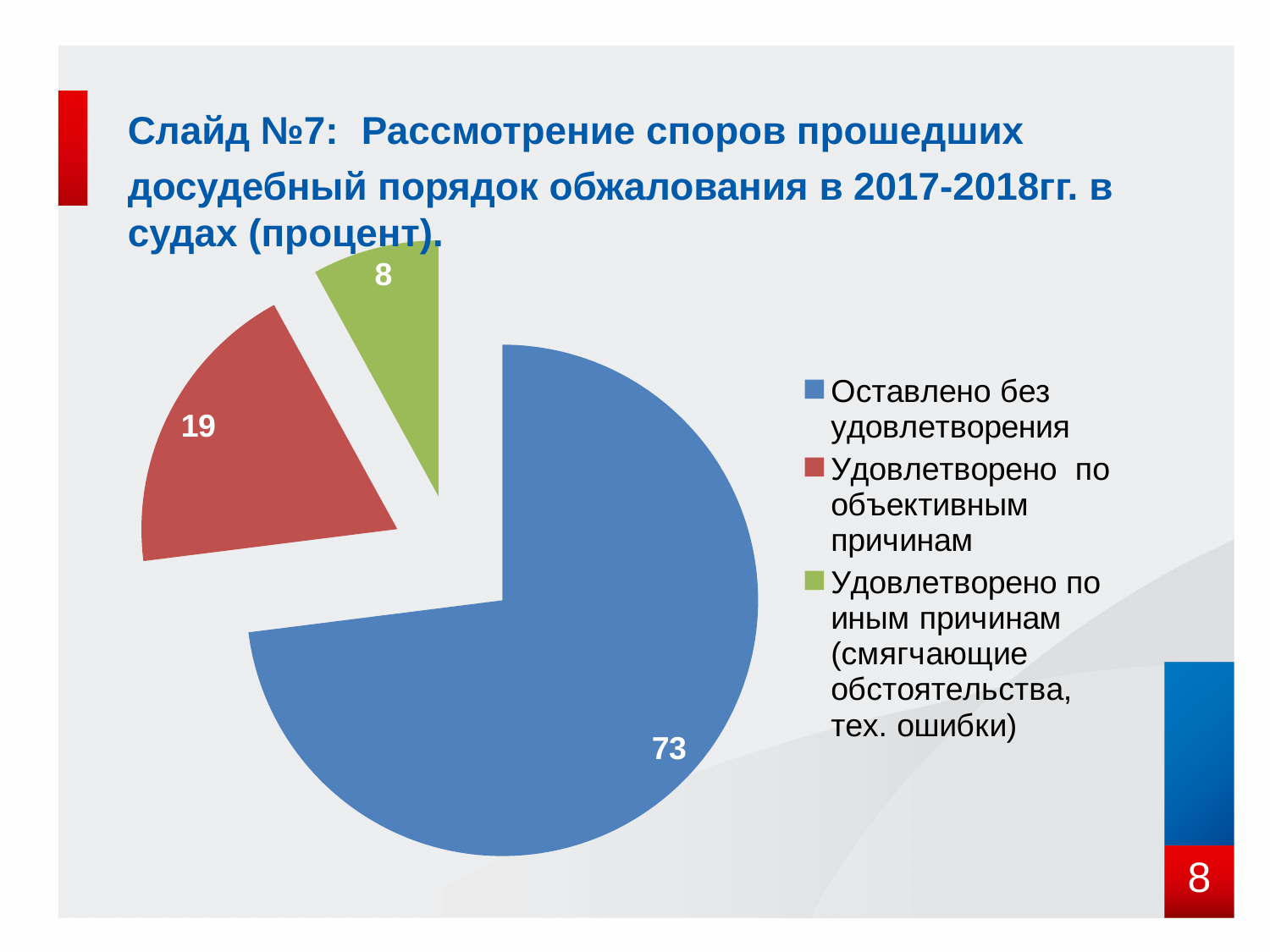
What is the value for "Оставлено без удовлетворения"? 73 Which is larger: "Удовлетворено по объективным причинам" or "Удовлетворено по иным причинам"? Удовлетворено по объективным причинам What is the value for "Удовлетворено по объективным причинам"? 19 How many slices does the pie chart have? 3 What colour is the slice for "Удовлетворено по иным причинам"? green Which category has the largest slice? Оставлено без удовлетворения What is the difference between the values for "Удовлетворено по объективным причинам" and "Удовлетворено по иным причинам"? 11 What kind of chart is shown on the slide? pie chart What is the difference between the values for "Оставлено без удовлетворения" and "Удовлетворено по объективным причинам"? 54 What colour is the slice for "Оставлено без удовлетворения"? blue Which category has the smallest slice? Удовлетворено по иным причинам (смягчающие обстоятельства, тех. ошибки) What is the value for "Удовлетворено по иным причинам (смягчающие обстоятельства, тех. ошибки)"? 8